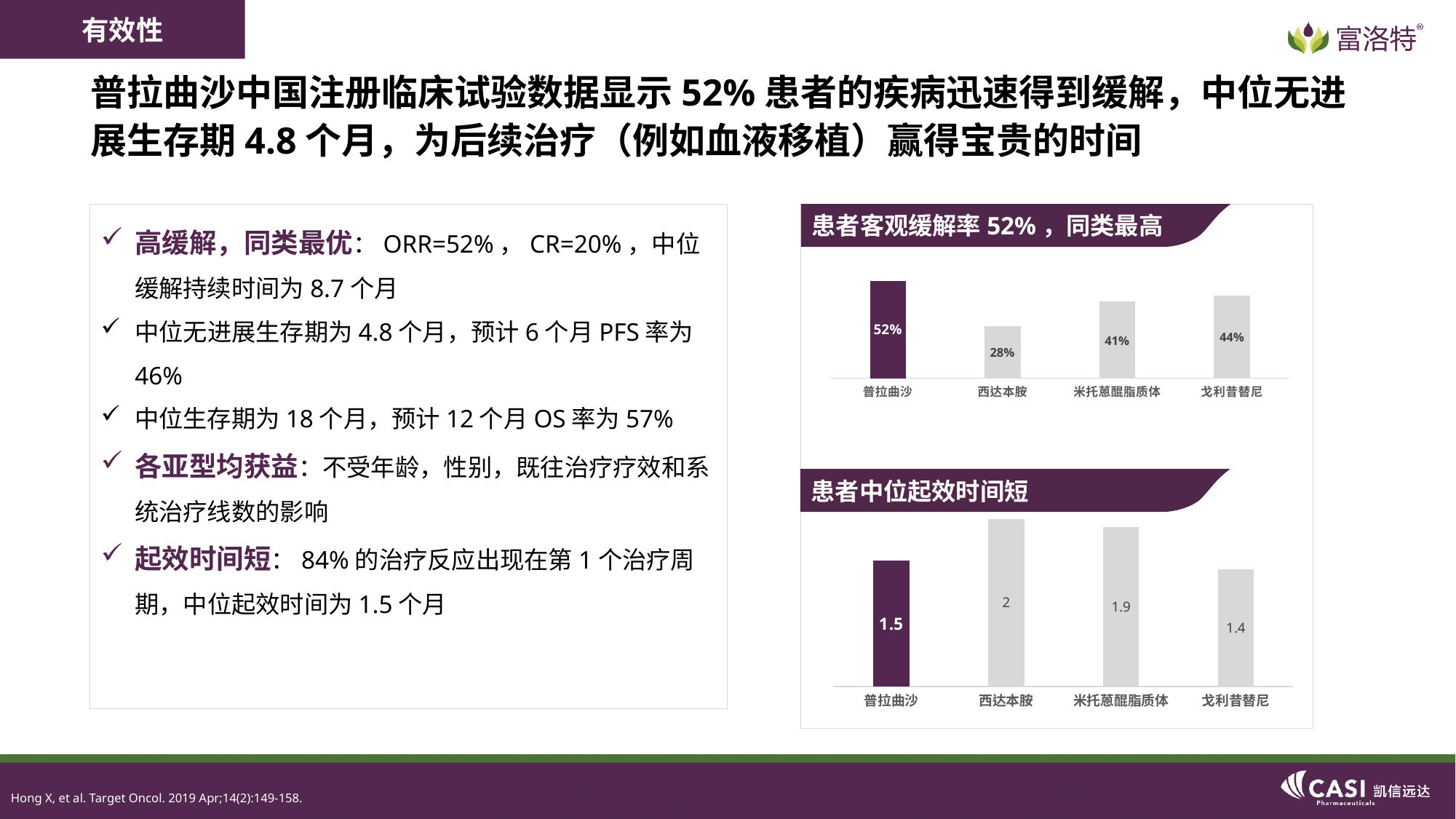
In the bottom chart (患者中位起效时间短), what is the value for 米托蒽醌脂质体? 1.9 In the top chart (患者客观缓解率 52%，同类最高), which is larger, 米托蒽醌脂质体 or 戈利昔替尼? 戈利昔替尼 In the bottom chart (患者中位起效时间短), which category has the lowest value? 戈利昔替尼 What type of chart is the bottom chart (患者中位起效时间短)? Bar chart In the top chart (患者客观缓解率 52%，同类最高), which bar is coloured purple rather than grey? 普拉曲沙 In the top chart (患者客观缓解率 52%，同类最高), what is the value for 西达本胺? 28% In the top chart (患者客观缓解率 52%，同类最高), what is the value for 普拉曲沙? 52% In the bottom chart (患者中位起效时间短), which category has the highest value? 西达本胺 In the top chart (患者客观缓解率 52%，同类最高), what is the difference between 普拉曲沙 and 戈利昔替尼? 8% In the bottom chart (患者中位起效时间短), what is the difference between 西达本胺 and 普拉曲沙? 0.5 In the top chart (患者客观缓解率 52%，同类最高), which category has the lowest value? 西达本胺 In the top chart (患者客观缓解率 52%，同类最高), how many categories are shown? 4